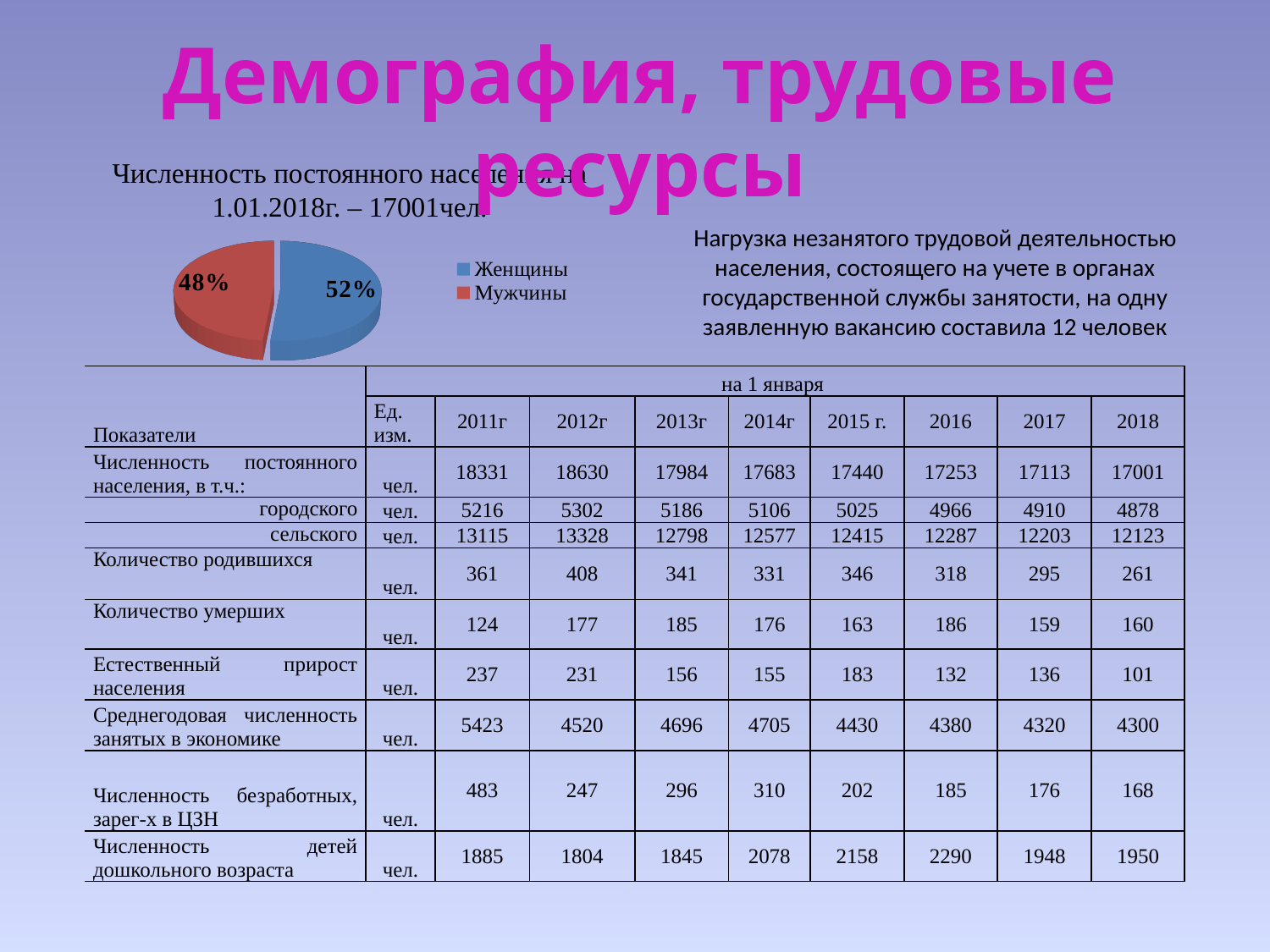
What is the share of the Мужчины slice in the pie chart? 48% What colour is the Женщины slice in the pie chart? blue Which slice of the pie chart is the largest? Женщины What share of the pie chart is labelled Женщины? 52% What kind of chart is shown on the slide? pie chart How many entries does the legend of the pie chart list? 2 What share of the pie chart is labelled Мужчины? 48% Which slice of the pie chart is the smallest? Мужчины In the pie chart, which is larger: Женщины or Мужчины? Женщины What colour is the Мужчины slice in the pie chart? red By how many percentage points does the Женщины slice exceed the Мужчины slice in the pie chart? 4 How many slices does the pie chart have? 2